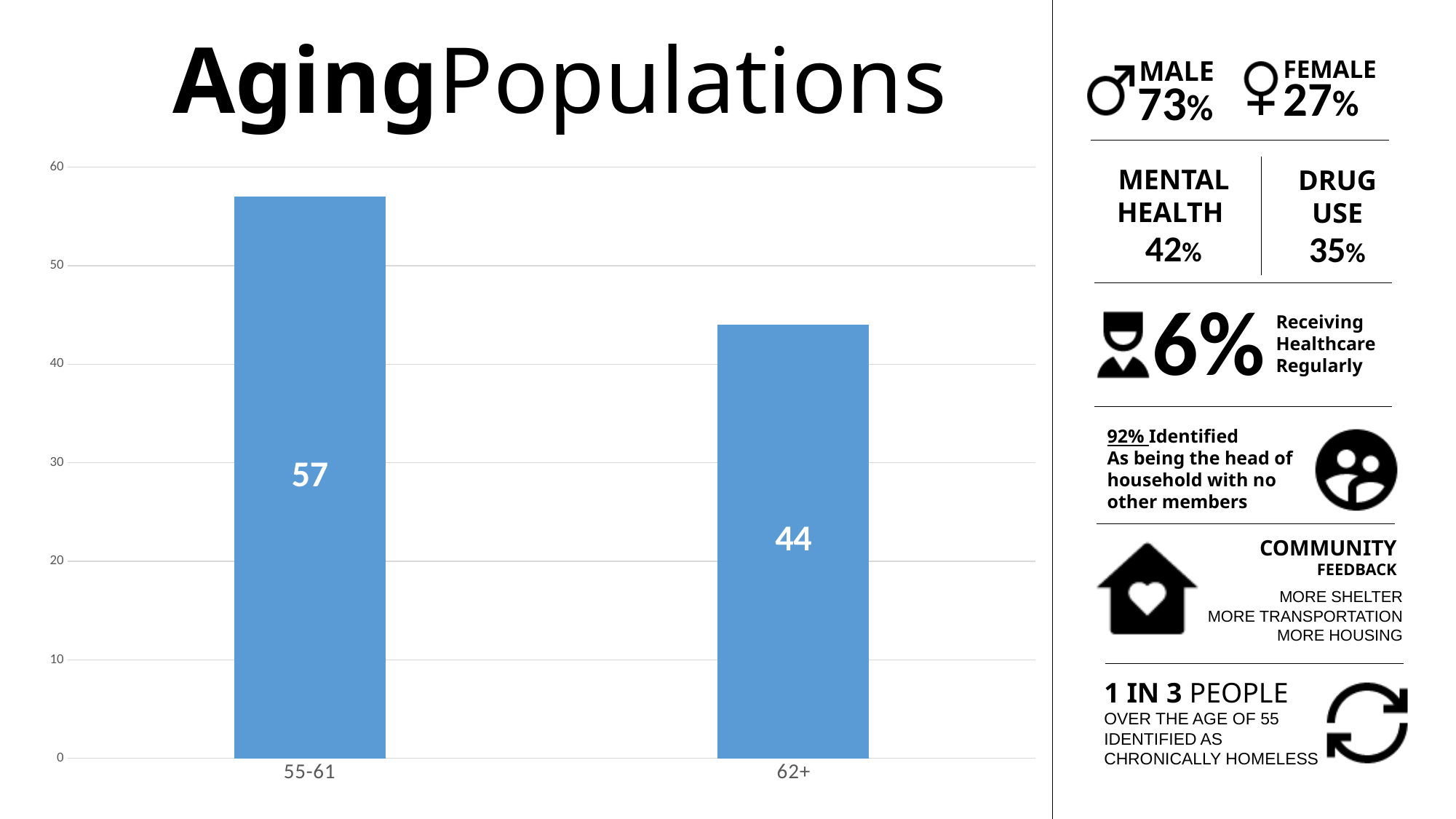
What is the maximum value shown on the vertical axis of the chart? 60 What is the difference between the values for 55-61 and 62+? 13 What is the value for the 55-61 age group? 57 Which is larger, the value for 55-61 or the value for 62+? 55-61 How many age groups are shown in the chart? 2 Is the value for 55-61 greater or less than 50? greater Do the values rise or fall from the 55-61 group to the 62+ group? fall Is the value for 62+ greater or less than 50? less What is the value for the 62+ age group? 44 Which age group has the highest value? 55-61 What kind of chart is shown on the slide? bar chart Which age group has the lowest value? 62+